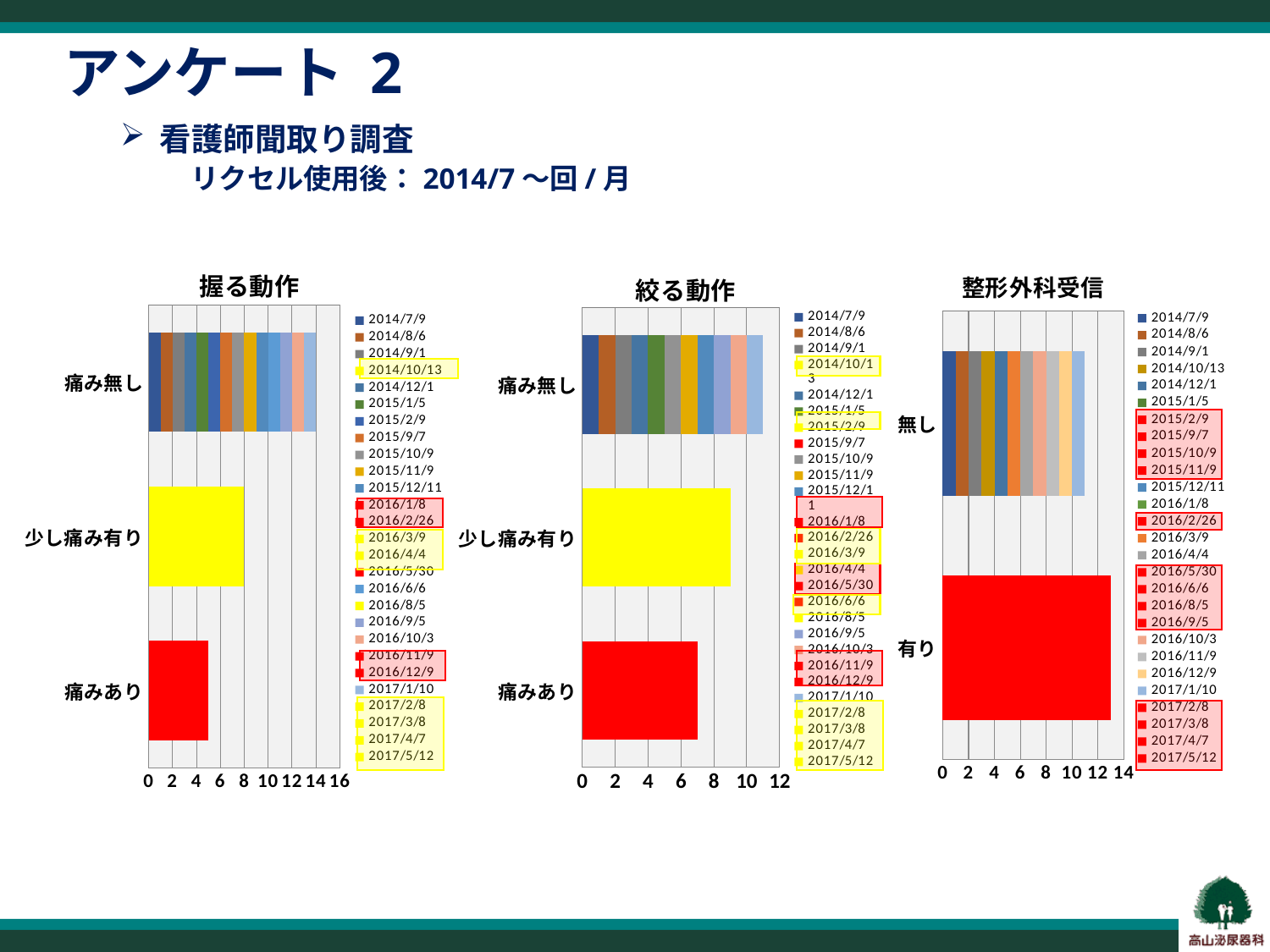
In the 絞る動作 chart, which category has the shortest bar? 痛みあり What is the highest tick value on the x axis of the 握る動作 chart? 16 In the 握る動作 chart, which category has the shortest bar? 痛みあり In the 整形外科受信 chart, which bar is longer, 無し or 有り? 有り In the 握る動作 chart, which category has the longest bar? 痛み無し In the 握る動作 chart, is the value for 痛みあり greater or less than 6? less How many categories are shown on the y axis of the 整形外科受信 chart? 2 What kind of chart is the 握る動作 chart? bar chart How many categories are shown on the y axis of the 握る動作 chart? 3 In the 握る動作 chart, is the total for 痛み無し greater or less than 12? greater In the 絞る動作 chart, is the value for 少し痛み有り greater or less than 8? greater